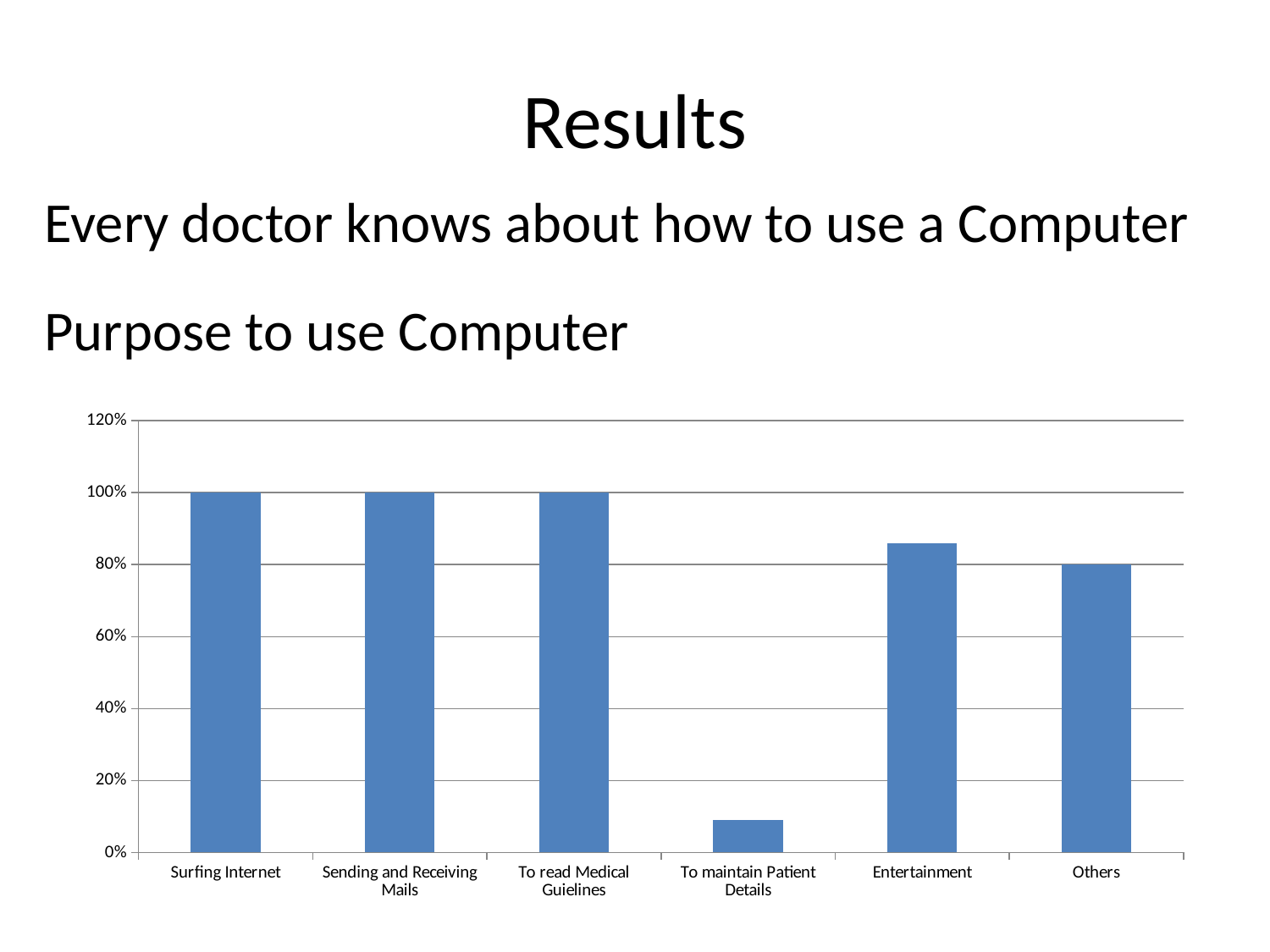
What is the value for Surfing Internet? 100% Which category has the lowest value? To maintain Patient Details Is the value for Entertainment greater or less than 80%? greater What is the value for Sending and Receiving Mails? 100% What is the value for To read Medical Guielines? 100% How many categories reach 100%? 3 What is the heading text directly above the chart? Purpose to use Computer Is the value for To maintain Patient Details greater or less than 20%? less How many categories are shown on the x axis of the chart? 6 Which is larger, the value for Entertainment or the value for To maintain Patient Details? Entertainment What kind of chart is shown on the slide? bar chart Is the value for Others greater or less than 100%? less